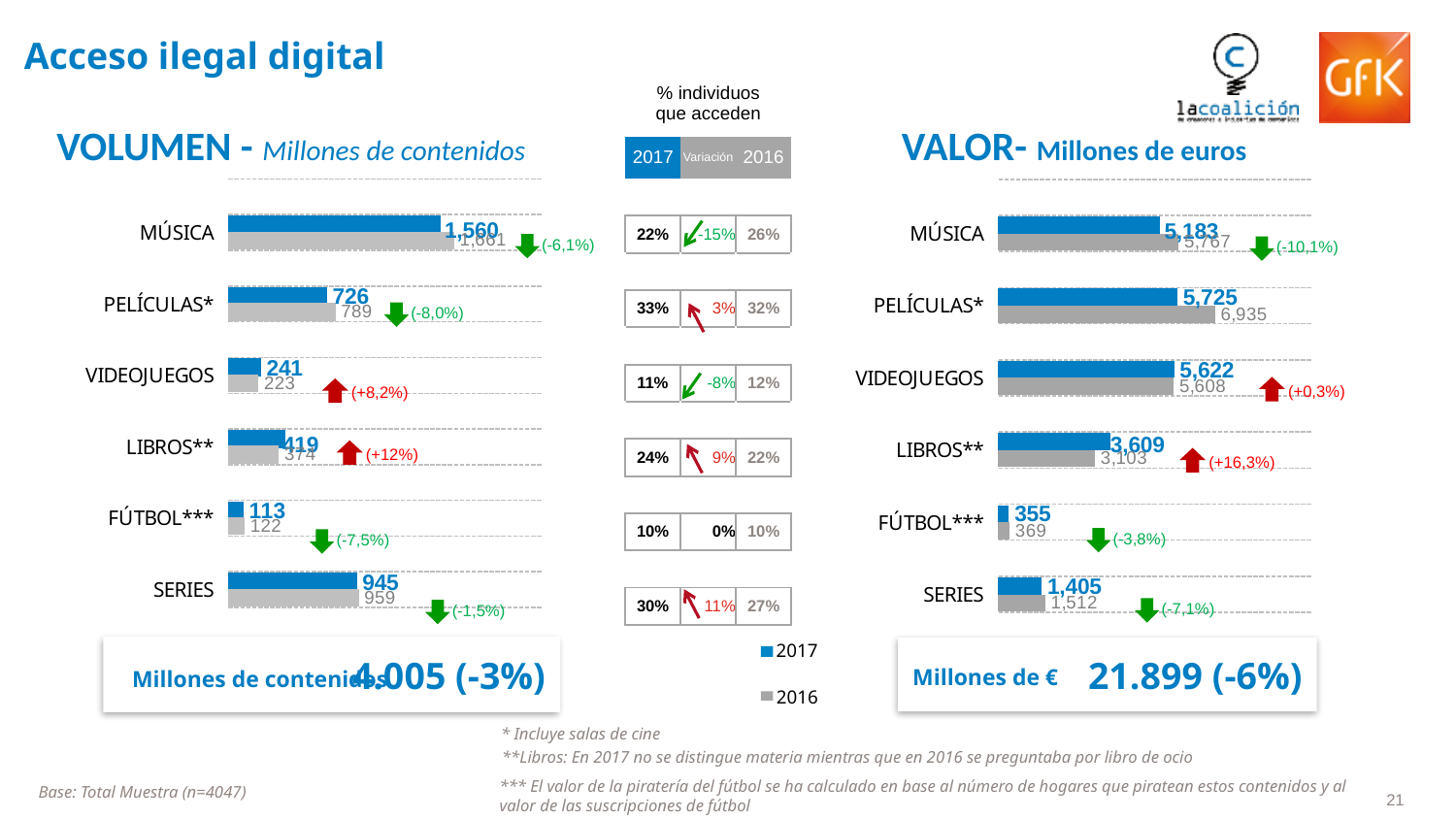
In the VOLUMEN - Millones de contenidos chart, which category has the lowest 2017 value? FÚTBOL*** How many categories are shown in the VALOR - Millones de euros chart? 6 In the VALOR - Millones de euros chart, what percentage variation is shown next to LIBROS**? (+16,3%) How many series does the legend list for the bar charts? 2 In the VOLUMEN - Millones de contenidos chart, what is the difference between the 2016 and 2017 values for PELÍCULAS*? 63 In the VOLUMEN - Millones de contenidos chart, which year has the larger value for VIDEOJUEGOS, 2017 or 2016? 2017 In the VOLUMEN - Millones de contenidos chart, what is the 2017 value for MÚSICA? 1,560 In the VOLUMEN - Millones de contenidos chart, what is the 2016 value for SERIES? 959 In the VALOR - Millones de euros chart, which category has the lowest 2017 value? FÚTBOL*** In the VALOR - Millones de euros chart, what is the difference between the 2017 and 2016 values for VIDEOJUEGOS? 14 In the VALOR - Millones de euros chart, what is the 2017 value for PELÍCULAS*? 5,725 In the VOLUMEN - Millones de contenidos chart, which category has the highest 2017 value? MÚSICA